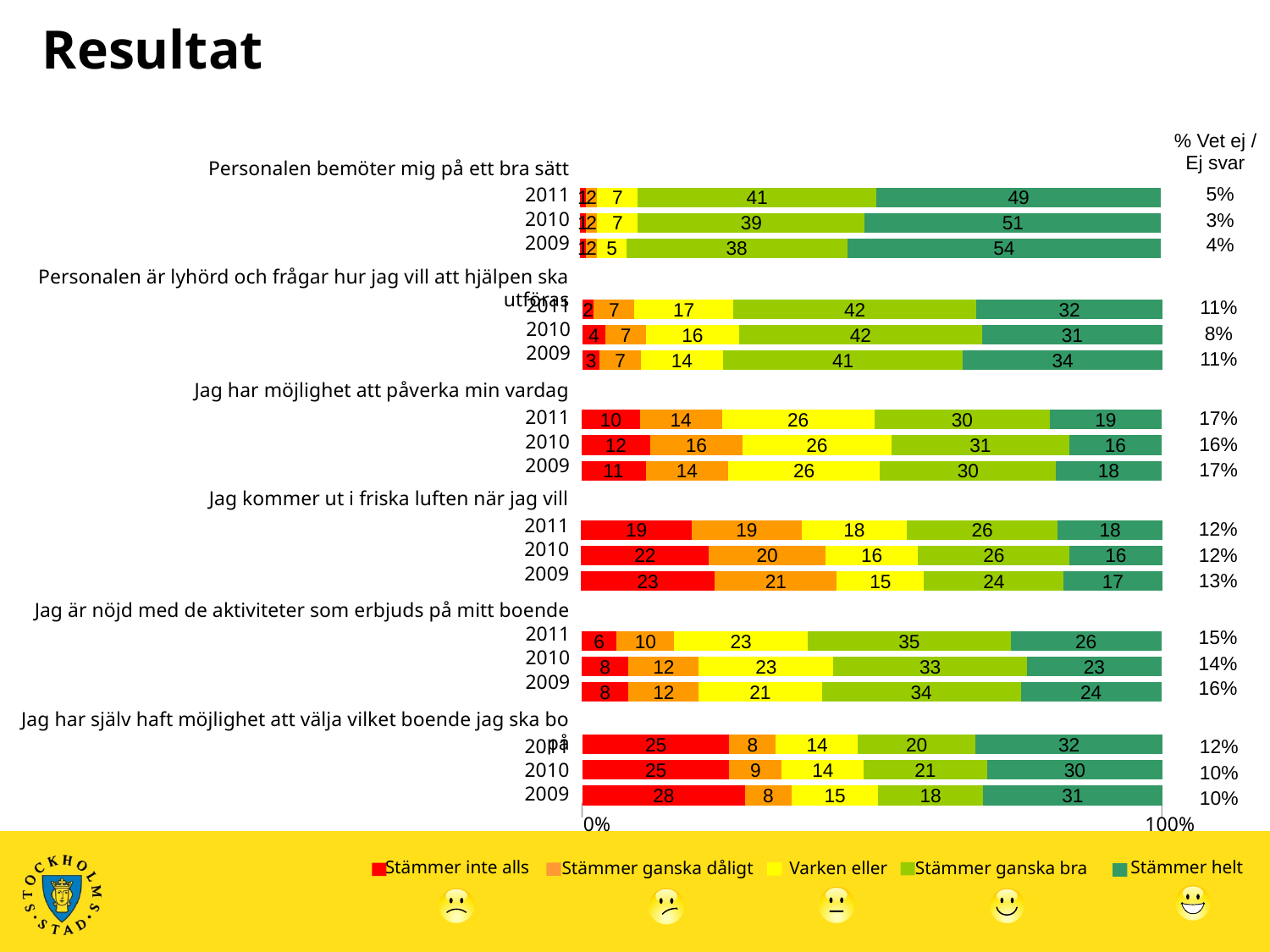
Which legend entry is shown in red? Stämmer inte alls What is the difference between the "Stämmer inte alls" values for "Jag kommer ut i friska luften när jag vill" in 2009 and 2011? 4 Which year has the highest "Stämmer inte alls" value for "Jag har själv haft möjlighet att välja vilket boende jag ska bo på"? 2009 What is the value of "Stämmer inte alls" for "Jag kommer ut i friska luften när jag vill" in 2009? 23 For "Jag är nöjd med de aktiviteter som erbjuds på mitt boende", which is larger: the "Stämmer ganska bra" value in 2011 or in 2010? 2011 What is the value of "Stämmer ganska bra" for "Personalen är lyhörd och frågar hur jag vill att hjälpen ska utföras" in 2010? 42 What kind of chart is shown on the slide? Stacked bar chart What is the value of "Varken eller" for "Jag har möjlighet att påverka min vardag" in 2011? 26 What is the "% Vet ej / Ej svar" value for "Jag har möjlighet att påverka min vardag" in 2011? 17% How many series does the legend list? 5 What is the value of "Stämmer helt" for "Personalen bemöter mig på ett bra sätt" in 2011? 49 What is the difference between the "Stämmer helt" values for "Personalen bemöter mig på ett bra sätt" in 2009 and 2011? 5